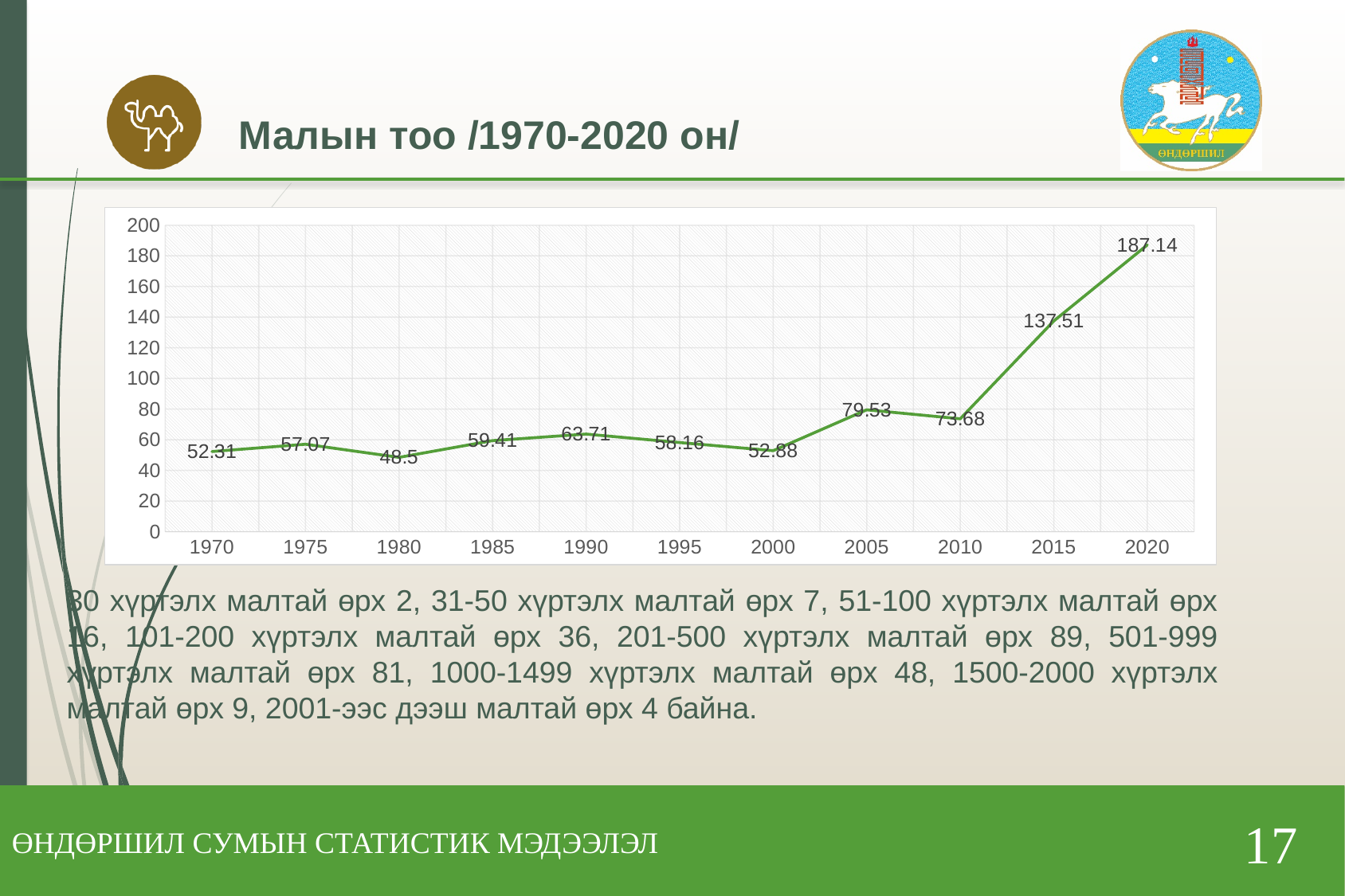
What is the value for 2020? 187.14 Is the value for 2015 greater or less than 120? greater Which is larger, the value for 1990 or the value for 1995? 1990 Do the values rise or fall between 2010 and 2020? rise What type of chart is shown on the slide? line chart How many data points are plotted on the chart? 11 Which year has the highest value? 2020 Which year has the lowest value? 1980 What is the value for 1980? 48.5 What is the title of the slide containing the chart? Малын тоо /1970-2020 он/ What is the value for 2005? 79.53 What is the difference between the values for 2020 and 2015? 49.63